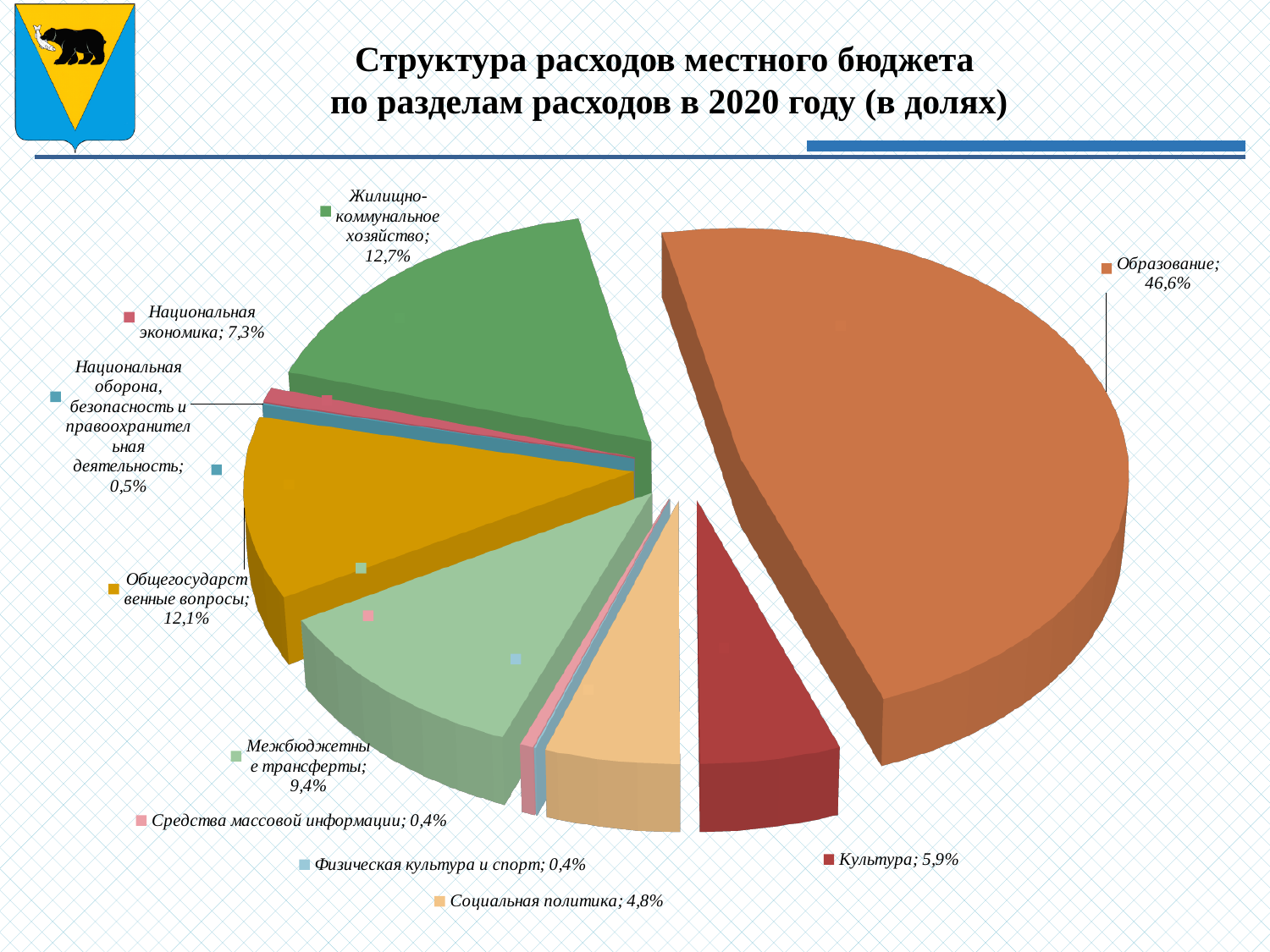
What share of local budget expenditure goes to Образование? 46,6% How many sections (slices) does the pie chart show? 10 What is the share for Социальная политика? 4,8% What is the difference between the shares of Образование and Жилищно-коммунальное хозяйство? 33,9% What is the share for Культура? 5,9% What is the share for Межбюджетные трансферты? 9,4% Which section has the largest share of expenditure? Образование What is the share for Общегосударственные вопросы? 12,1% What year does the chart title say the expenditure structure refers to? 2020 What kind of chart is shown on the slide? Pie chart What is the share for Жилищно-коммунальное хозяйство? 12,7% Which is larger: the share for Национальная экономика or the share for Культура? Национальная экономика